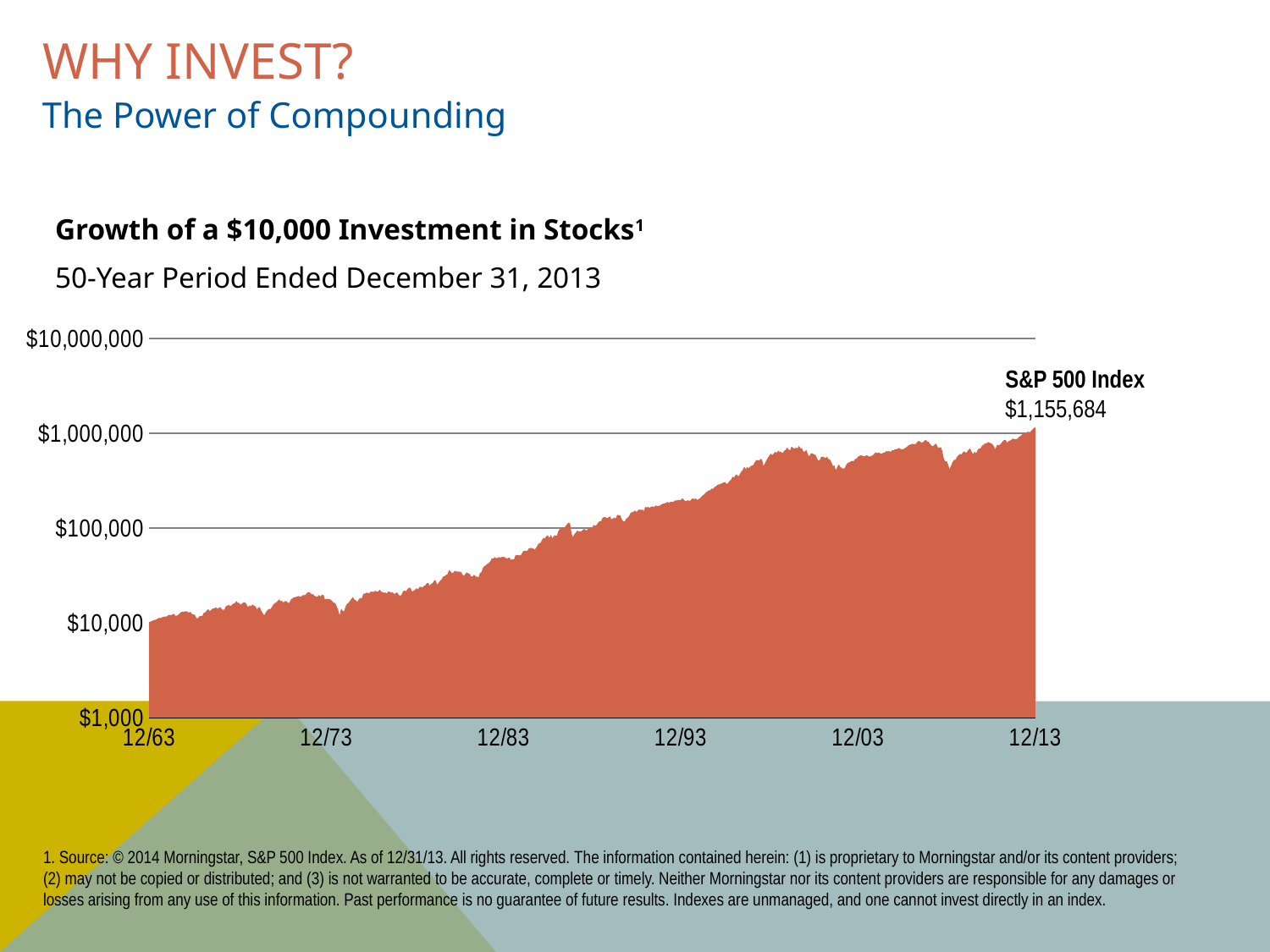
What kind of chart is shown on the slide? Area chart What is the value of the S&P 500 Index investment at the end of the period (12/13)? $1,155,684 How many date labels are shown on the x axis? 6 Does the value of the investment generally rise or fall from 12/63 to 12/13? Rise Is the value of the investment at 12/03 greater or less than $1,000,000? less Is the value of the investment at 12/73 greater or less than $100,000? less Is the value of the investment at 12/93 greater or less than $100,000? greater By how much did the investment grow from its initial $10,000 to its ending value of $1,155,684? $1,145,684 Which index does the plotted series represent? S&P 500 Index What is the highest value labelled on the y axis? $10,000,000 What was the initial investment amount shown in the chart title? $10,000